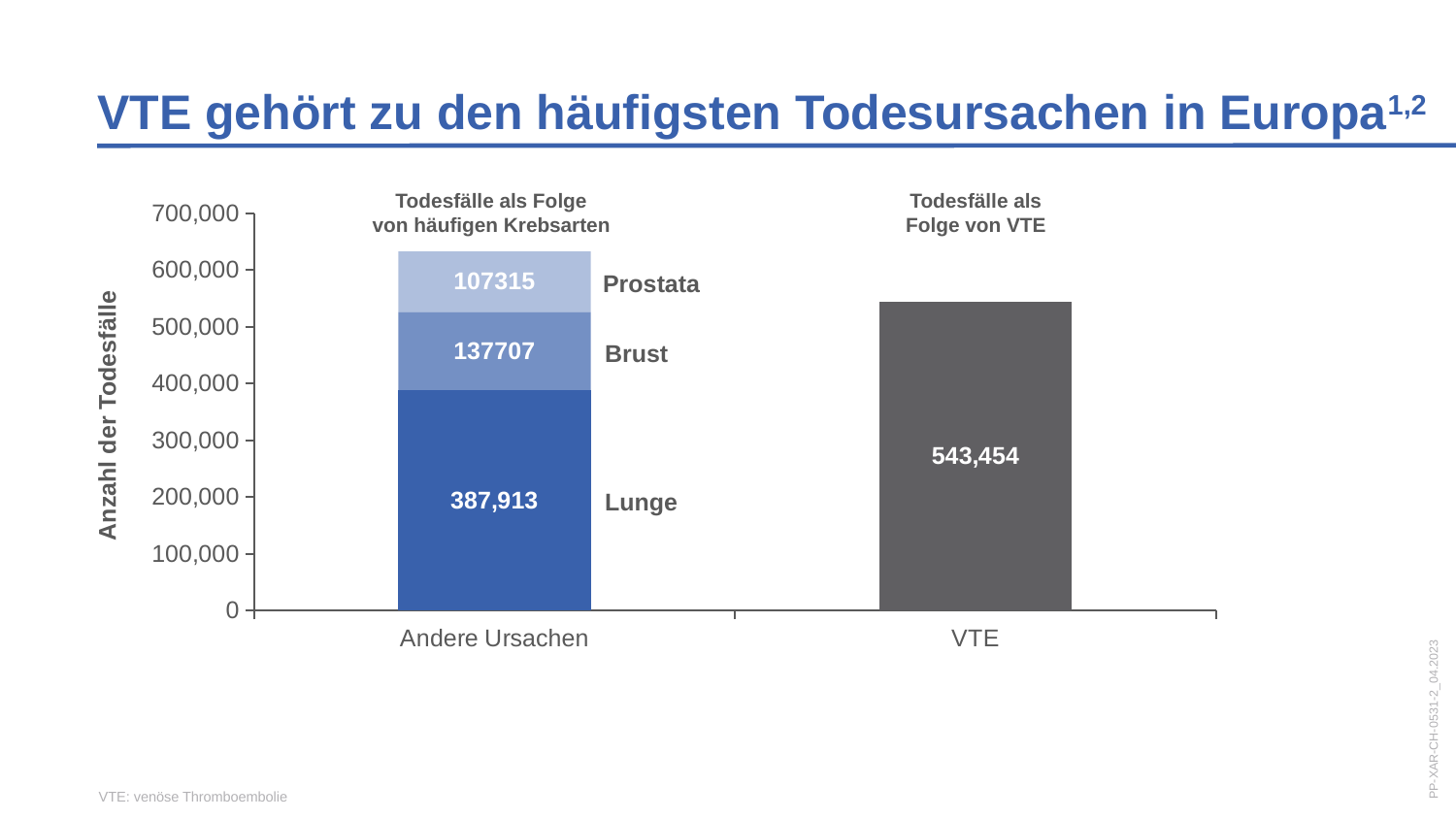
What is the value of the Brust segment in the Andere Ursachen bar? 137707 What is the total of the stacked Andere Ursachen bar? 632,935 What is the value for VTE? 543,454 Which is larger, the VTE bar or the Lunge segment of the Andere Ursachen bar? VTE What is the difference between the VTE value and the Lunge segment value? 155,541 What is the value of the Lunge segment in the Andere Ursachen bar? 387,913 How many categories are shown on the x axis? 2 What is the value of the Prostata segment in the Andere Ursachen bar? 107315 Which segment of the Andere Ursachen bar is the smallest? Prostata Is the value for VTE greater or less than 500,000? greater Which segment of the Andere Ursachen bar is the largest? Lunge What kind of chart is shown on the slide? Stacked bar chart